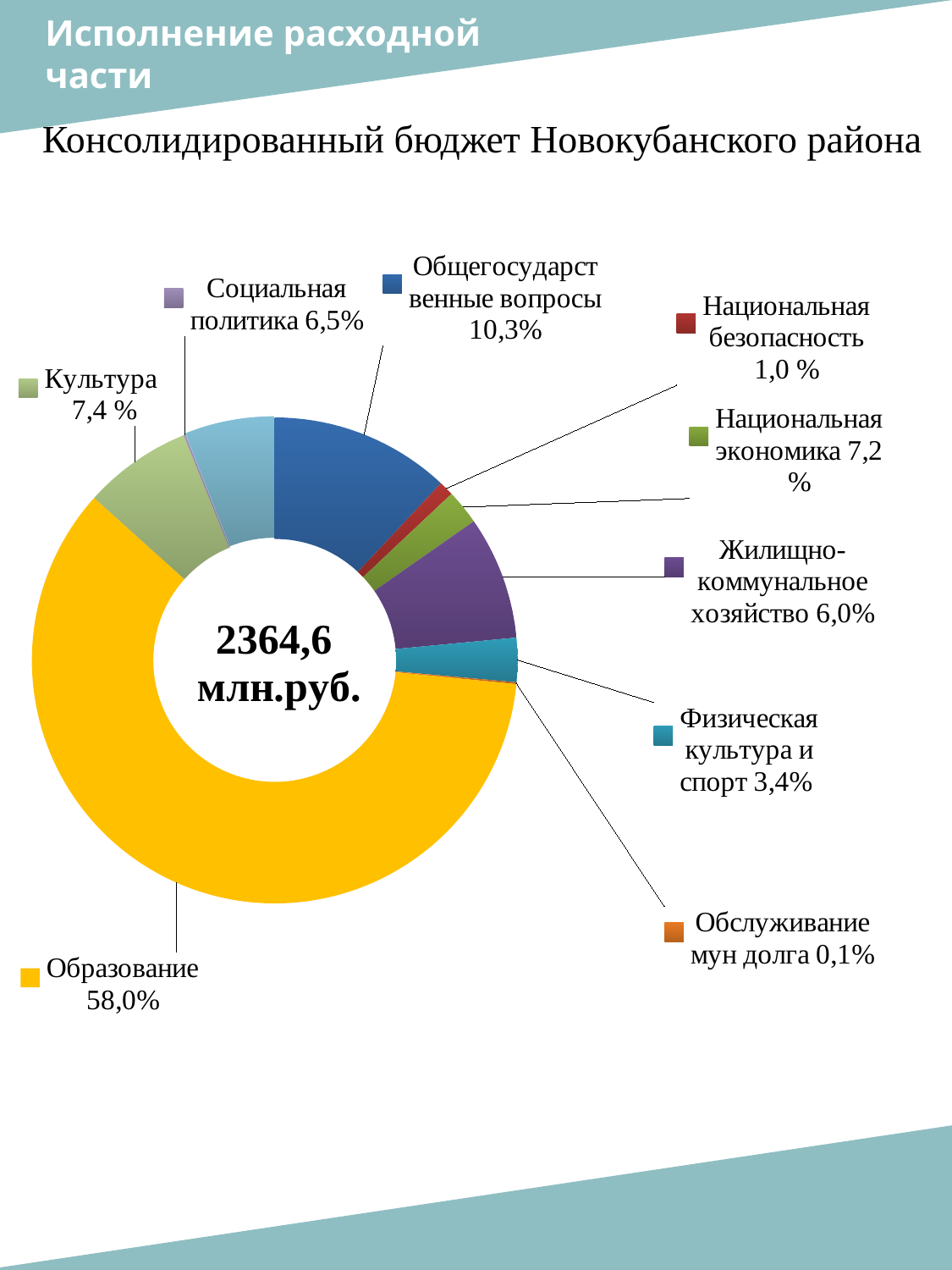
What kind of chart is shown on the slide? Doughnut chart What is the difference in percentage points between Общегосударственные вопросы and Национальная безопасность? 9,3 Which category has the largest share of the chart? Образование What is the difference in percentage points between Культура and Социальная политика? 0,9 What share of the chart does Образование account for? 58,0% What is the value shown for Жилищно-коммунальное хозяйство? 6,0% What total amount is printed in the centre of the chart? 2364,6 млн.руб. Which is larger, the share for Национальная экономика or the share for Жилищно-коммунальное хозяйство? Национальная экономика What is the value shown for Общегосударственные вопросы? 10,3% Which category has the smallest share of the chart? Обслуживание мун долга What is the value shown for Физическая культура и спорт? 3,4%